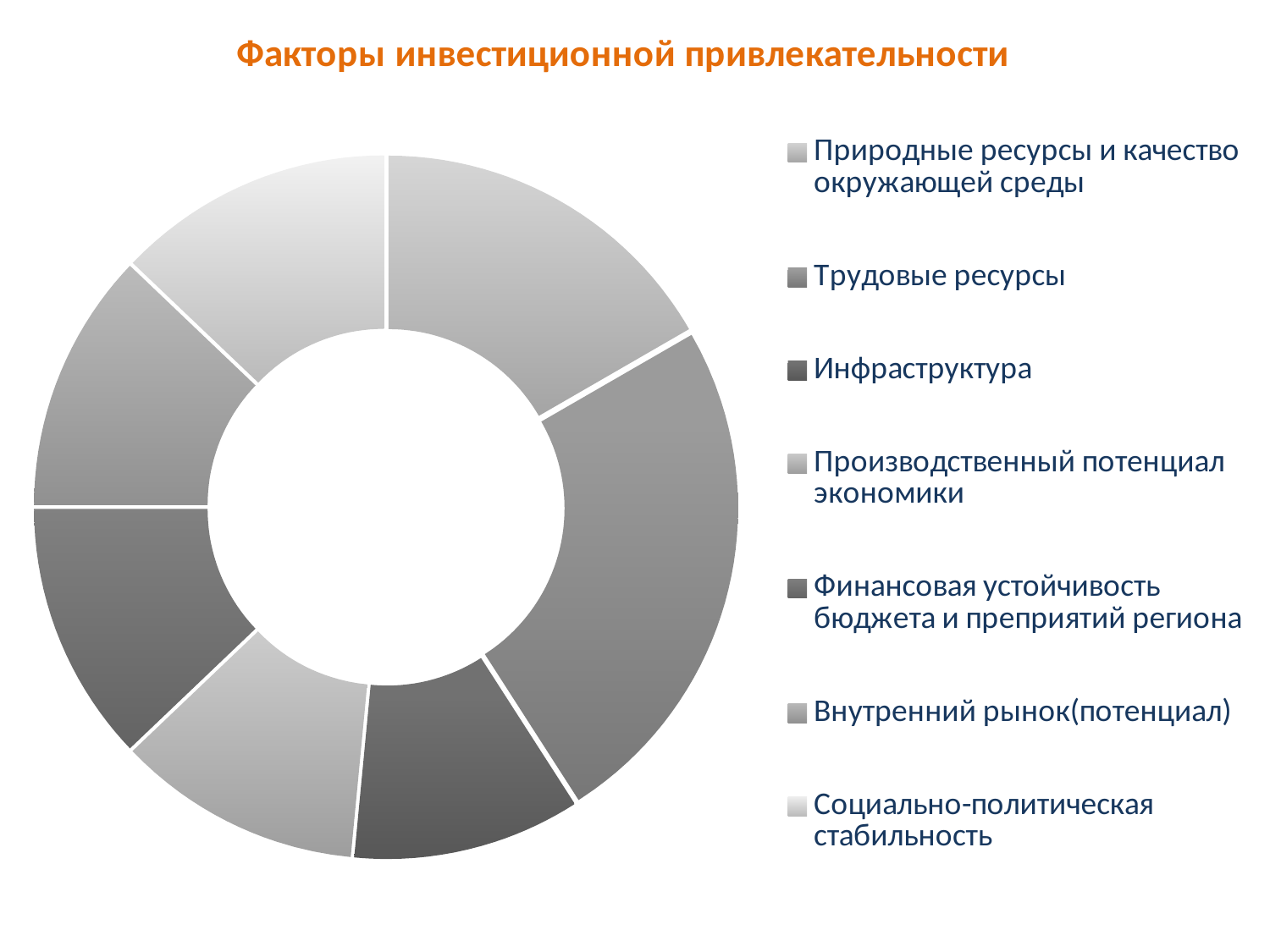
What kind of chart is shown on the slide? Doughnut (pie) chart Which segment is larger: Трудовые ресурсы or Производственный потенциал экономики? Трудовые ресурсы Which segment is larger: Трудовые ресурсы or Инфраструктура? Трудовые ресурсы How many categories (segments) does the chart have? 7 How many entries does the chart's legend list? 7 What is the title of the chart on the slide? Факторы инвестиционной привлекательности Which category has the largest segment in the chart? Трудовые ресурсы Which legend entry is listed first in the chart's legend? Природные ресурсы и качество окружающей среды Which segment is larger: Трудовые ресурсы or Социально-политическая стабильность? Трудовые ресурсы